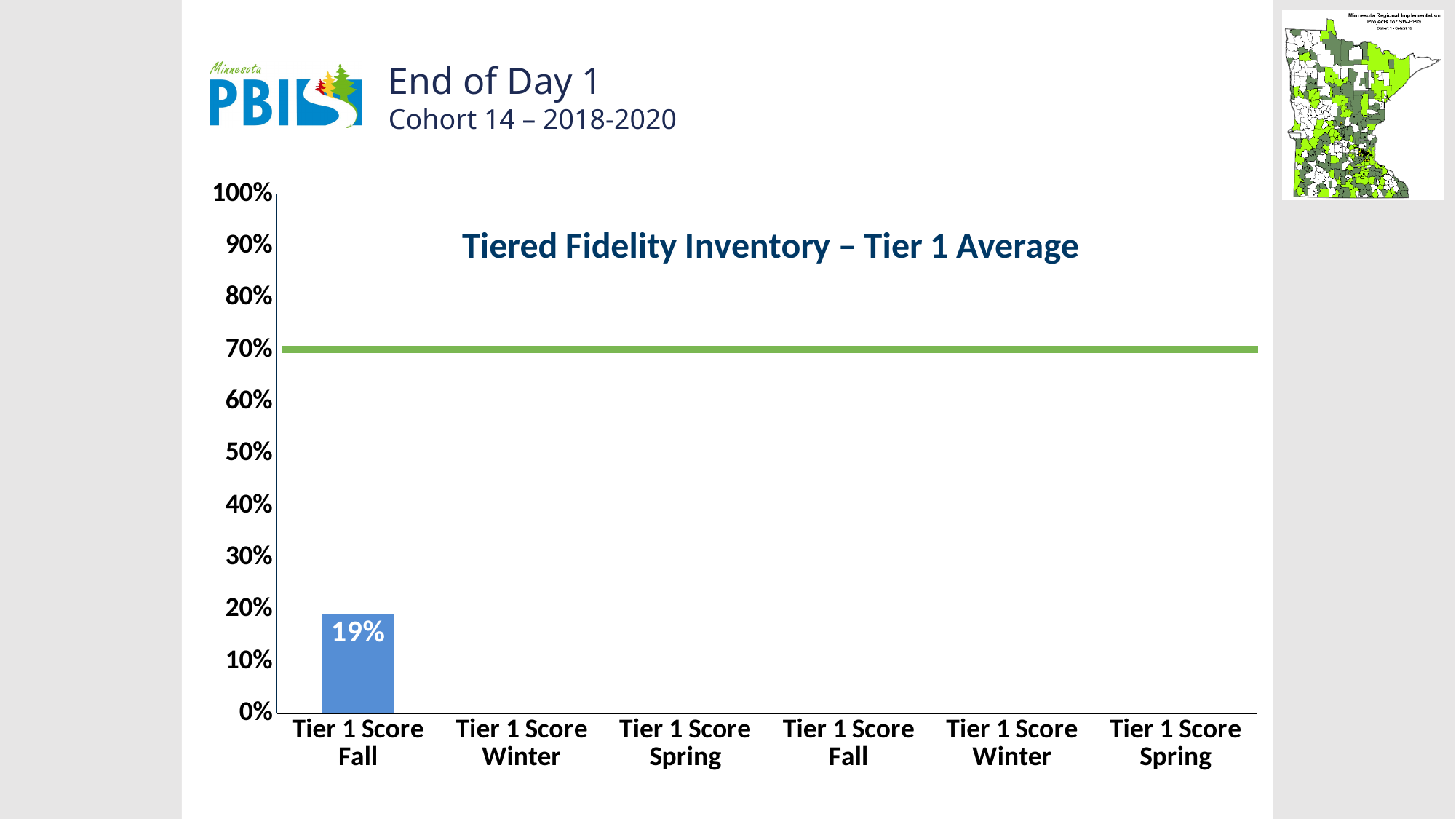
What is the title of the chart? Tiered Fidelity Inventory – Tier 1 Average How many bars have data plotted on the chart? 1 Is the value for the first Tier 1 Score Fall bar greater or less than 10%? greater How many categories are labelled along the x axis? 6 What is the value of the first Tier 1 Score Fall bar? 19% What is the maximum value shown on the y axis? 100% Is the first Tier 1 Score Fall bar above or below the green 70% line? below What kind of chart is shown on the slide? bar chart At what percentage does the green horizontal line sit? 70% What is the difference between the green line value and the first Tier 1 Score Fall bar? 51% Is the value for the first Tier 1 Score Fall bar greater or less than 20%? less